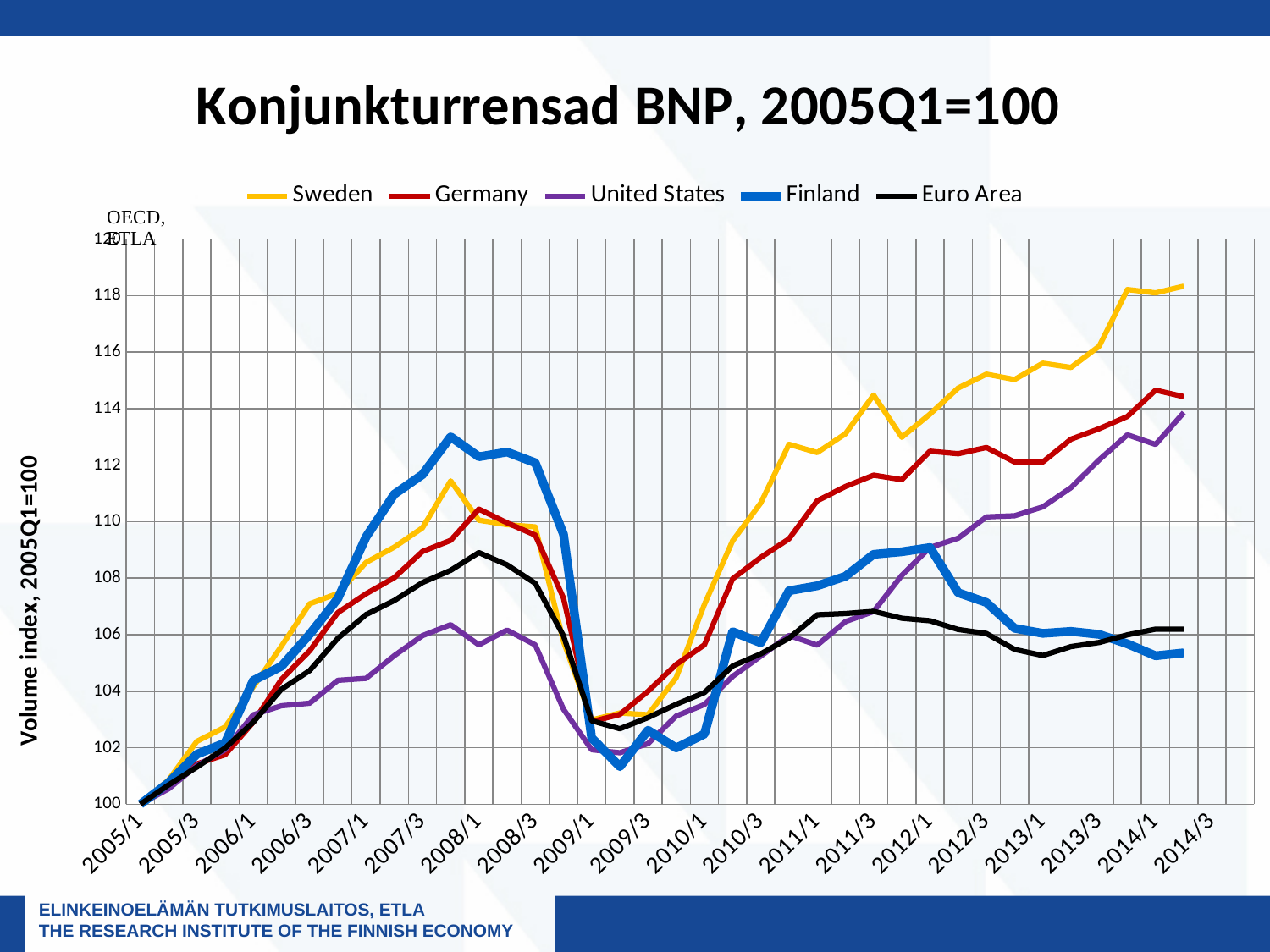
What kind of chart is shown on the slide? line chart What is the title of the vertical axis? Volume index, 2005Q1=100 At 2008/1, which is higher: Finland or Euro Area? Finland Is the value for Sweden at 2014/1 greater or less than 116? greater Is the value for Germany at 2014/1 greater or less than 112? greater Does the Euro Area line rise or fall between 2008/1 and 2009/1? fall Is the value for Finland at 2009/3 greater or less than 104? less Which series has the highest value at 2008/1? Finland How many series does the legend list? 5